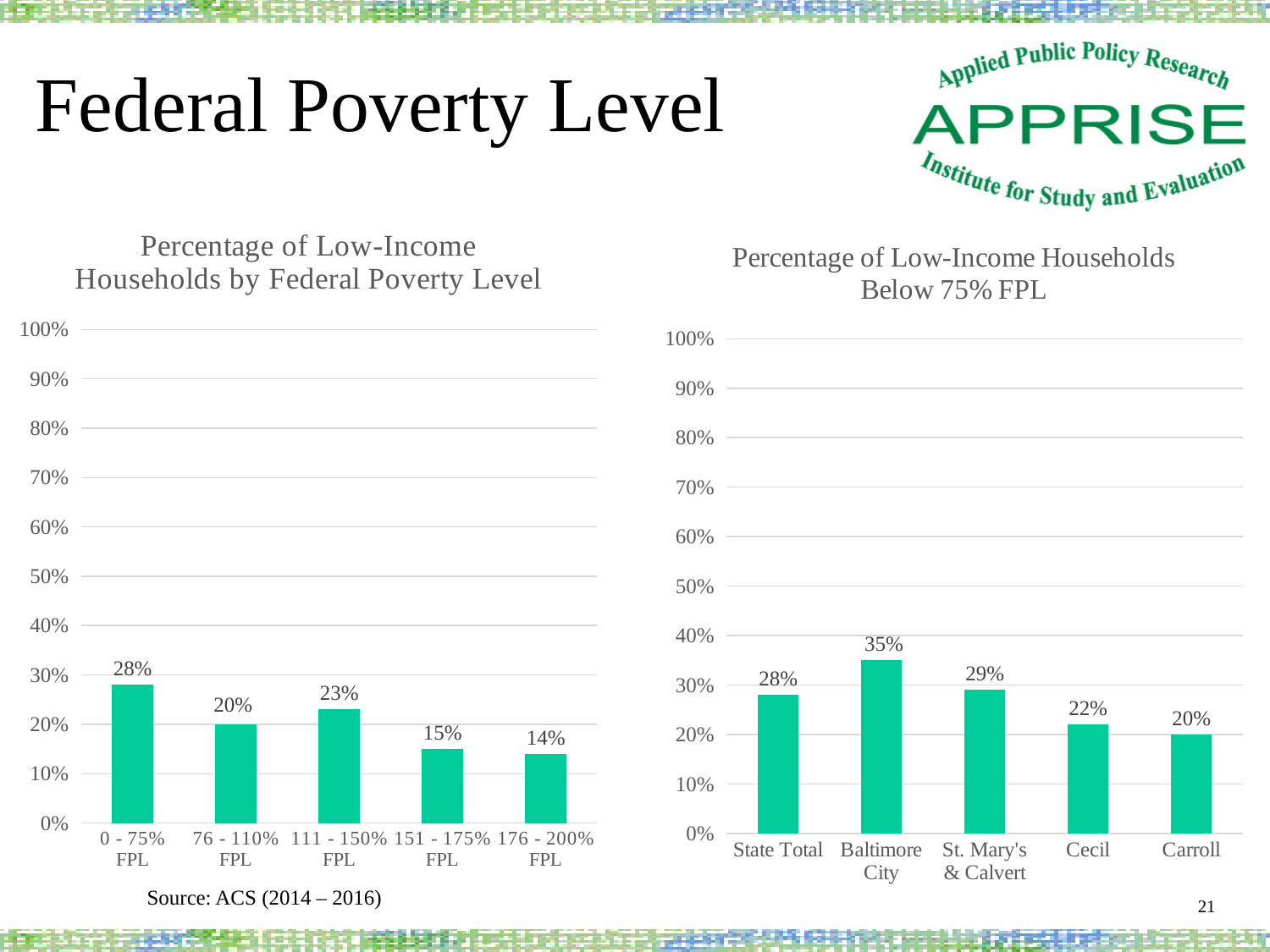
In the chart 'Percentage of Low-Income Households by Federal Poverty Level', which category has the lowest value? 176 - 200% FPL In the chart 'Percentage of Low-Income Households Below 75% FPL', what is the difference between the values for Baltimore City and State Total? 7% In the chart 'Percentage of Low-Income Households by Federal Poverty Level', what is the difference between the values for 0 - 75% FPL and 151 - 175% FPL? 13% In the chart 'Percentage of Low-Income Households by Federal Poverty Level', what is the value for 0 - 75% FPL? 28% In the chart 'Percentage of Low-Income Households by Federal Poverty Level', how many categories are shown? 5 In the chart 'Percentage of Low-Income Households Below 75% FPL', which is larger, the value for St. Mary's & Calvert or the value for Carroll? St. Mary's & Calvert In the chart 'Percentage of Low-Income Households Below 75% FPL', what is the value for Cecil? 22% In the chart 'Percentage of Low-Income Households Below 75% FPL', which category has the lowest value? Carroll In the chart 'Percentage of Low-Income Households Below 75% FPL', which category has the highest value? Baltimore City What kind of chart is 'Percentage of Low-Income Households Below 75% FPL'? Bar chart In the chart 'Percentage of Low-Income Households by Federal Poverty Level', what is the value for 111 - 150% FPL? 23% In the chart 'Percentage of Low-Income Households Below 75% FPL', what is the value for Baltimore City? 35%